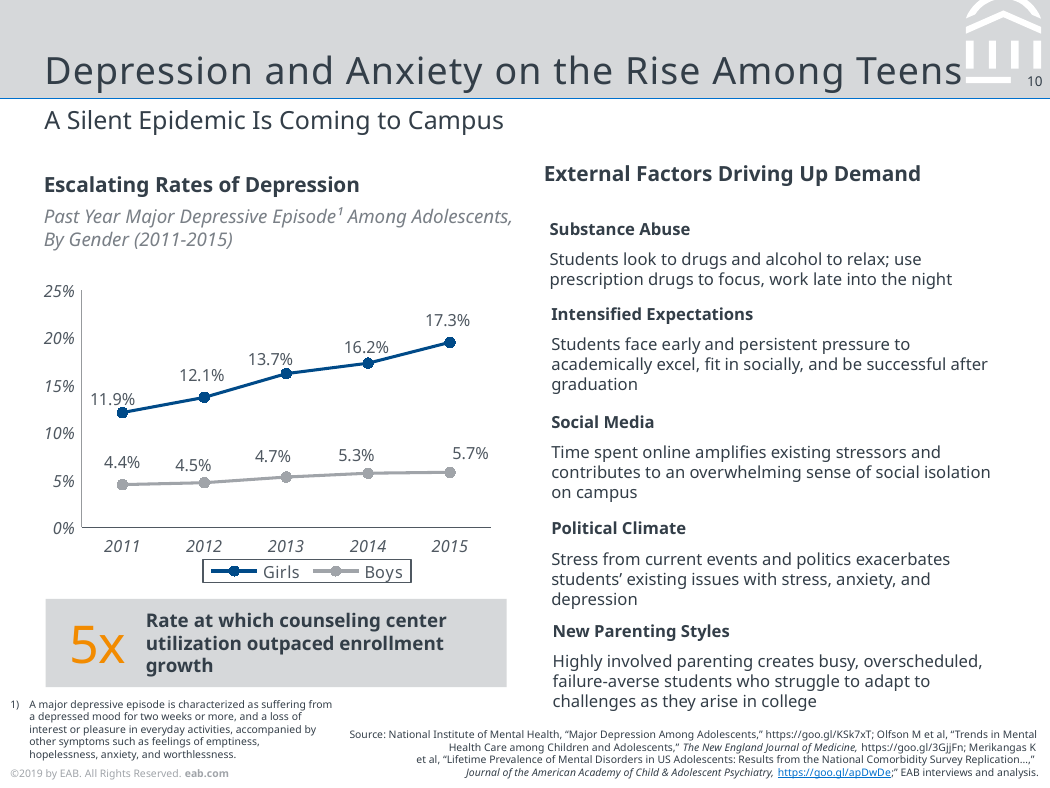
How many series does the chart legend list? 2 What was the rate for boys in 2011? 4.4% What was the rate for girls in 2013? 13.7% What type of chart is used to show the rates of depression by gender? Line chart What was the rate of past year major depressive episode among girls in 2015? 17.3% By how much did the girls' rate increase from 2011 to 2015? 5.4% How many years are plotted on the x axis of the chart? 5 In which year was the rate for girls highest? 2015 Does the rate for girls rise or fall from 2011 to 2015? Rise Which series had the higher rate in 2014, Girls or Boys? Girls In which year was the rate for boys lowest? 2011 What is the difference between the girls' and boys' rates in 2015? 11.6%